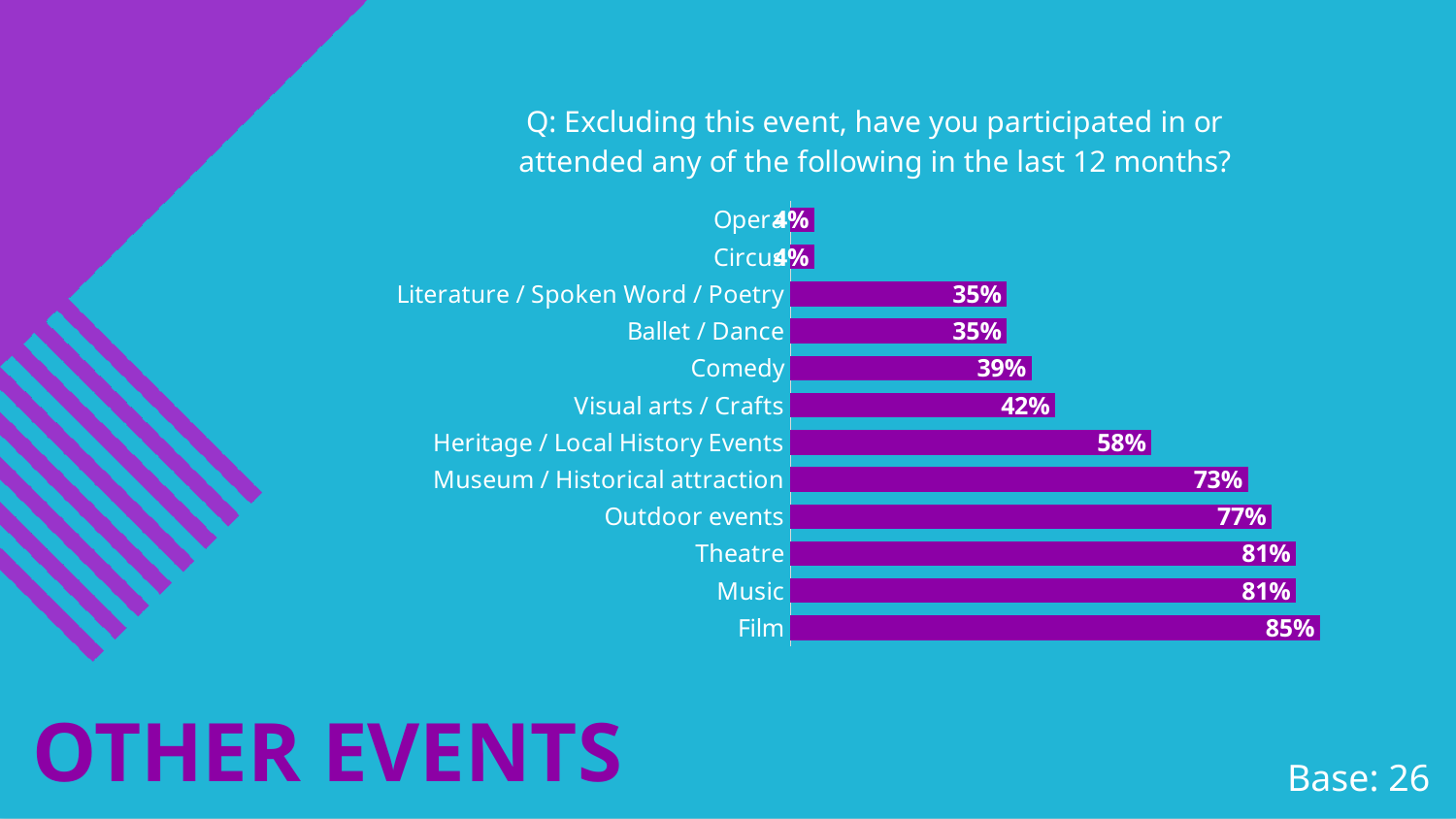
What is the value shown for Heritage / Local History Events? 58% What is the value shown for Museum / Historical attraction? 73% What is the difference between the values for Film and Outdoor events? 8% Which is larger, the value for Theatre or the value for Heritage / Local History Events? Theatre Which category has the highest value in the chart? Film What type of chart is shown on the slide? Bar chart Which is larger, the value for Comedy or the value for Visual arts / Crafts? Visual arts / Crafts How many categories are shown in the chart? 12 What is the difference between the values for Museum / Historical attraction and Comedy? 34% What is the value shown for Visual arts / Crafts? 42% What is the base (number of respondents) stated on the slide? 26 What percentage of respondents attended Film in the last 12 months? 85%